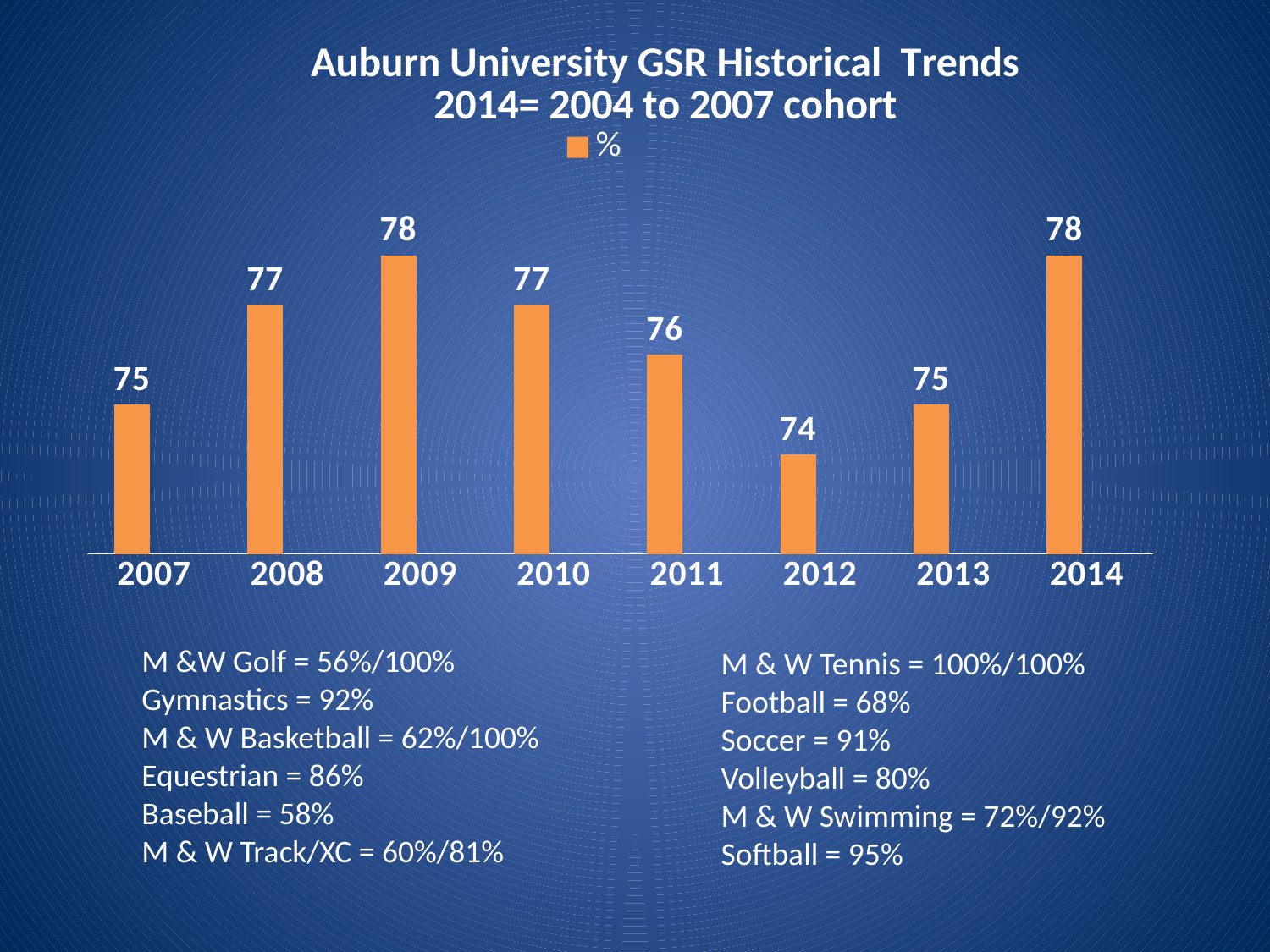
What is the value for 2011? 76 Which year has the lowest value? 2012 Which is larger, the value for 2008 or the value for 2013? 2008 What kind of chart is shown? bar chart What is the legend entry for the series? % How many series does the legend list? 1 What is the difference between the values for 2009 and 2007? 3 What is the value for 2012? 74 What is the value for 2007? 75 What is the difference between the values for 2014 and 2012? 4 How many years are shown on the x axis? 8 Which two years share the highest value of 78? 2009 and 2014